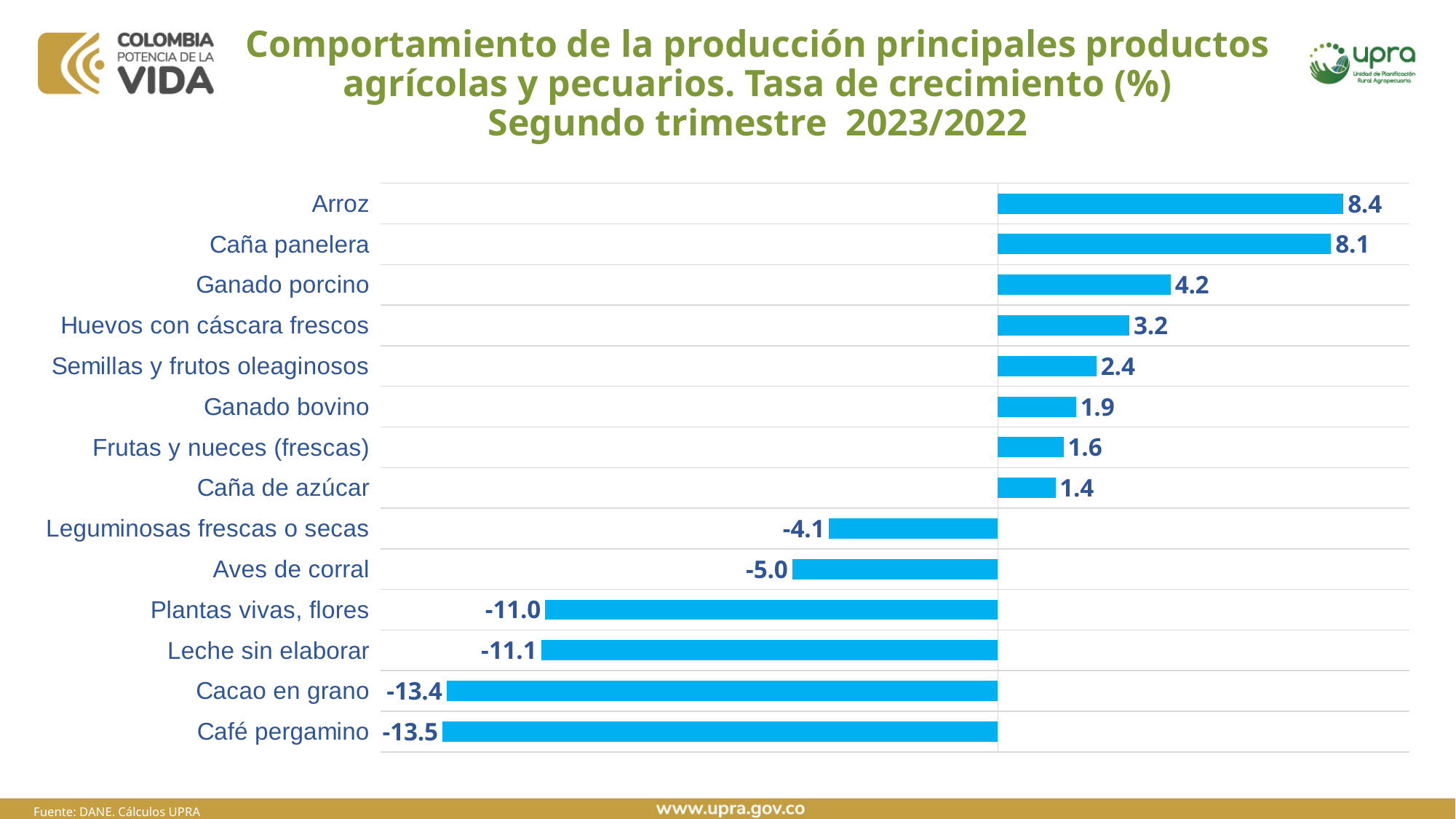
What is the value shown for Ganado bovino? 1.9 Which category has the highest value? Arroz What is the difference between the values for Ganado porcino and Huevos con cáscara frescos? 1.0 What is the value shown for Leche sin elaborar? -11.1 Which has a larger value, Semillas y frutos oleaginosos or Caña de azúcar? Semillas y frutos oleaginosos Which has a larger value, Aves de corral or Leguminosas frescas o secas? Leguminosas frescas o secas Which category has the lowest value? Café pergamino What kind of chart is shown on the slide? Bar chart How many categories are shown in the chart? 14 What is the difference between the values for Arroz and Caña panelera? 0.3 How many categories have a negative value? 6 What is the growth rate shown for Arroz? 8.4